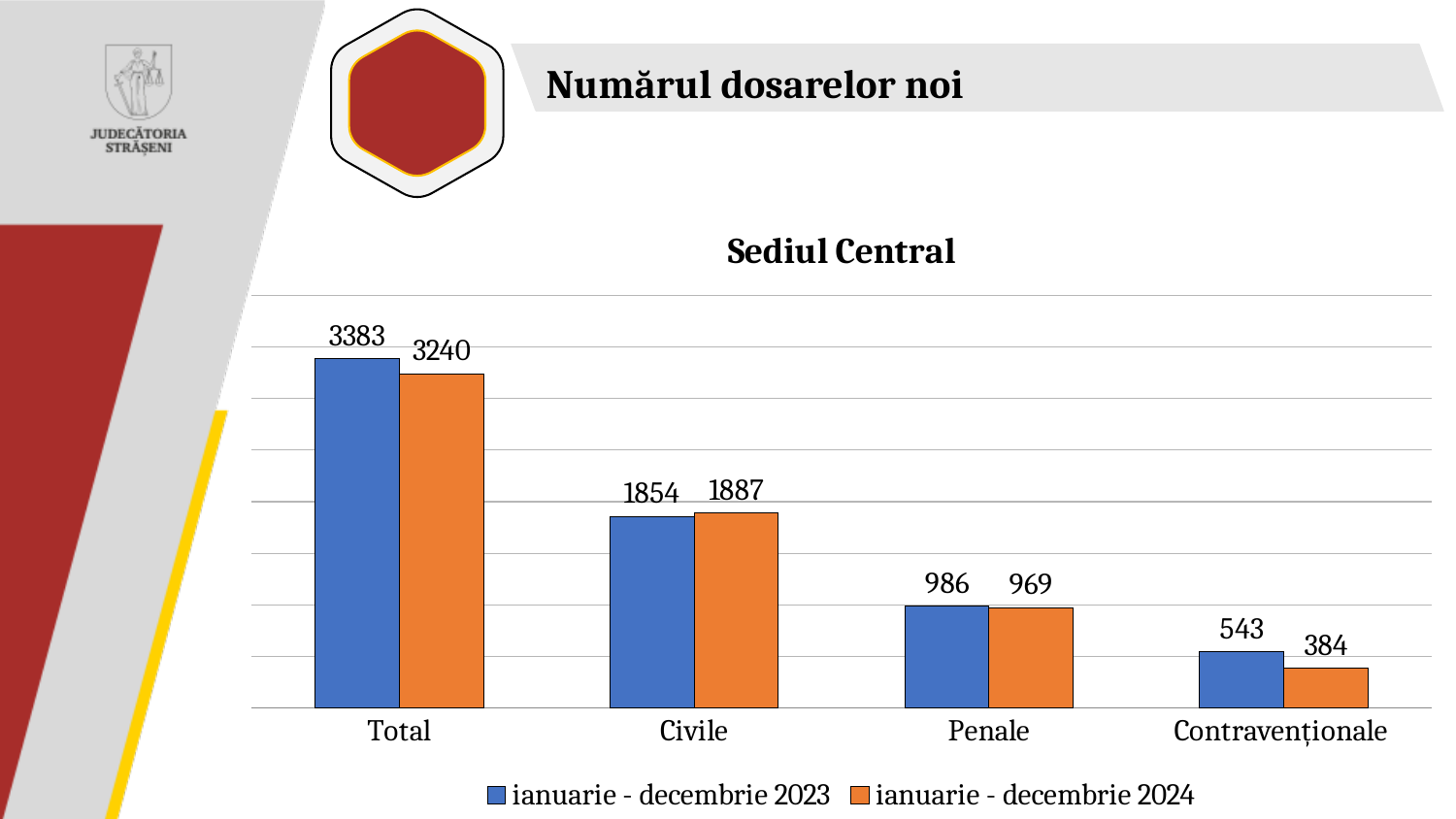
How many categories are shown on the x axis? 4 For Civile, which series has the larger value: ianuarie - decembrie 2023 or ianuarie - decembrie 2024? ianuarie - decembrie 2024 What is the difference between the Contravenționale values for ianuarie - decembrie 2023 and ianuarie - decembrie 2024? 159 What is the value for Penale in the ianuarie - decembrie 2024 series? 969 Which category has the lowest value in the ianuarie - decembrie 2024 series? Contravenționale What is the value for Civile in the ianuarie - decembrie 2024 series? 1887 What kind of chart is shown on the slide? bar chart What is the value for Contravenționale in the ianuarie - decembrie 2023 series? 543 What is the difference between the Total values for ianuarie - decembrie 2023 and ianuarie - decembrie 2024? 143 What is the title of the chart? Sediul Central How many series does the legend list? 2 Which category has the highest value in the ianuarie - decembrie 2023 series? Total